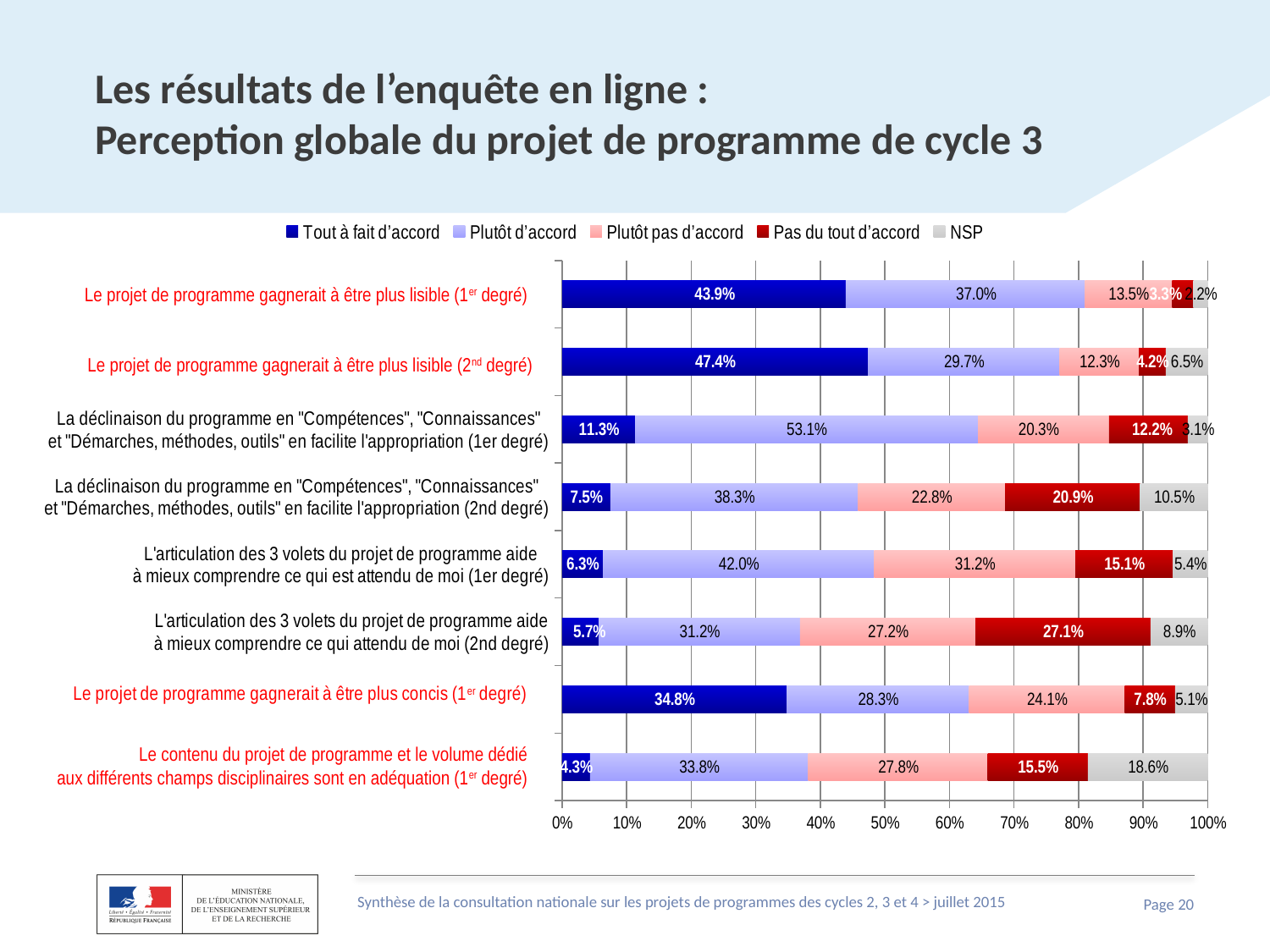
What is the "Plutôt d'accord" value for "La déclinaison du programme en "Compétences", "Connaissances" et "Démarches, méthodes, outils" en facilite l'appropriation (1er degré)"? 53.1% What is the NSP value for "Le contenu du projet de programme et le volume dédié aux différents champs disciplinaires sont en adéquation (1er degré)"? 18.6% How many series does the legend list? 5 Which statement has the highest "Tout à fait d'accord" percentage? Le projet de programme gagnerait à être plus lisible (2nd degré) What percentage of respondents answered "Tout à fait d'accord" for "Le projet de programme gagnerait à être plus lisible (2nd degré)"? 47.4% What is the difference between the "Tout à fait d'accord" values for "Le projet de programme gagnerait à être plus lisible" in the 2nd degré and the 1er degré? 3.5% Which statement has the lowest "Tout à fait d'accord" percentage? Le contenu du projet de programme et le volume dédié aux différents champs disciplinaires sont en adéquation (1er degré) Which is larger: the "Pas du tout d'accord" value for "La déclinaison du programme ... (2nd degré)" or for "La déclinaison du programme ... (1er degré)"? La déclinaison du programme ... (2nd degré) What type of chart is shown on the slide? Stacked bar chart How many statements (categories) are shown in the chart? 8 What is the last entry in the chart legend? NSP Which statement has the highest "Pas du tout d'accord" percentage? L'articulation des 3 volets du projet de programme aide à mieux comprendre ce qui attendu de moi (2nd degré)